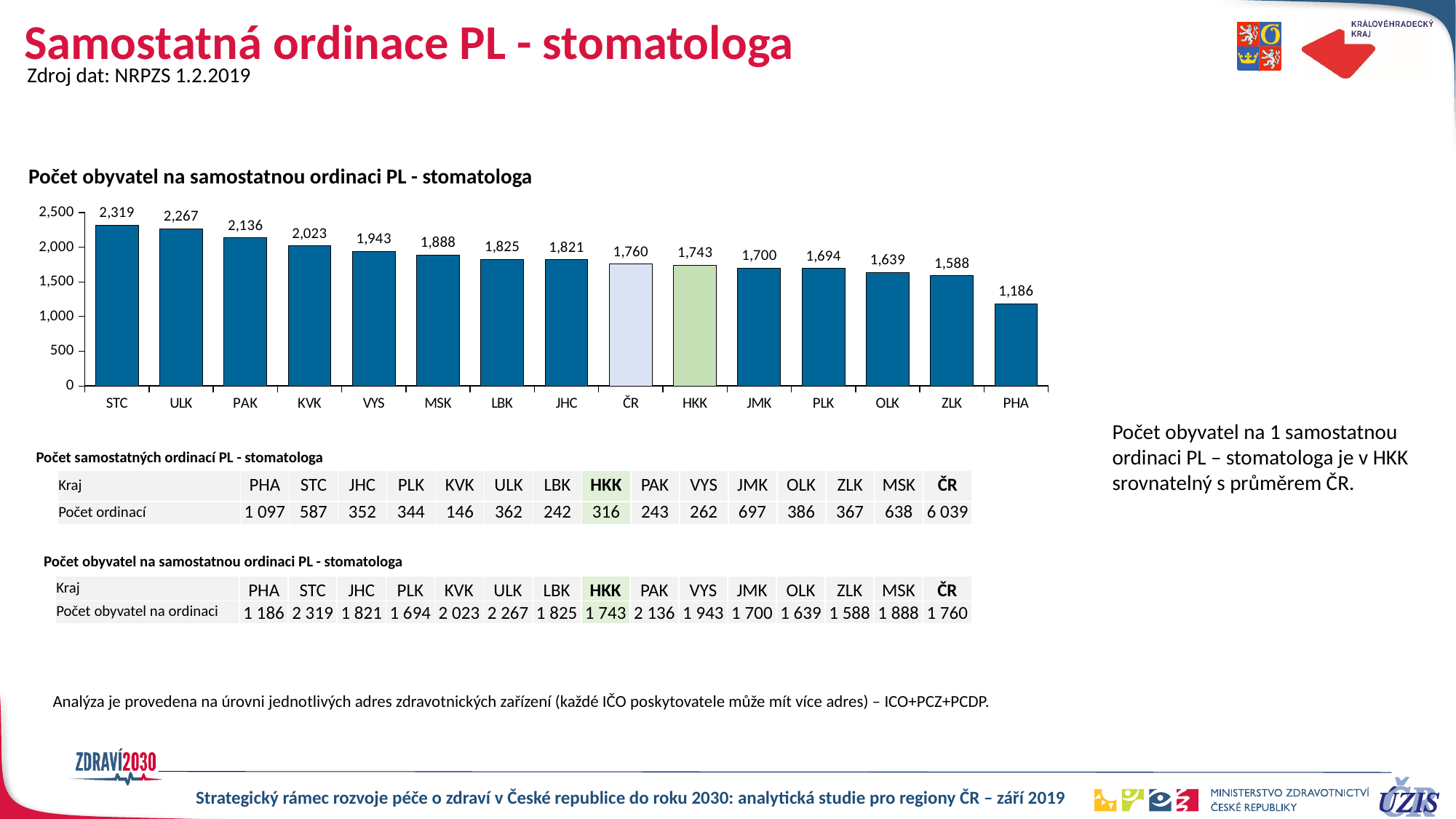
What kind of chart is shown on the slide? bar chart What is the difference between the values for ČR and HKK? 17 Do the values rise or fall from left to right along the x axis? fall What is the difference between the values for STC and PHA? 1,133 What is the value for PHA in the chart? 1,186 Which category has the highest value in the chart? STC Which is larger, the value for KVK or the value for MSK? KVK Is the value for ZLK greater or less than 1,500? greater Which category has the lowest value in the chart? PHA How many categories are shown on the x axis of the chart? 15 What is the value for ČR in the chart? 1,760 What is the value for HKK in the chart? 1,743